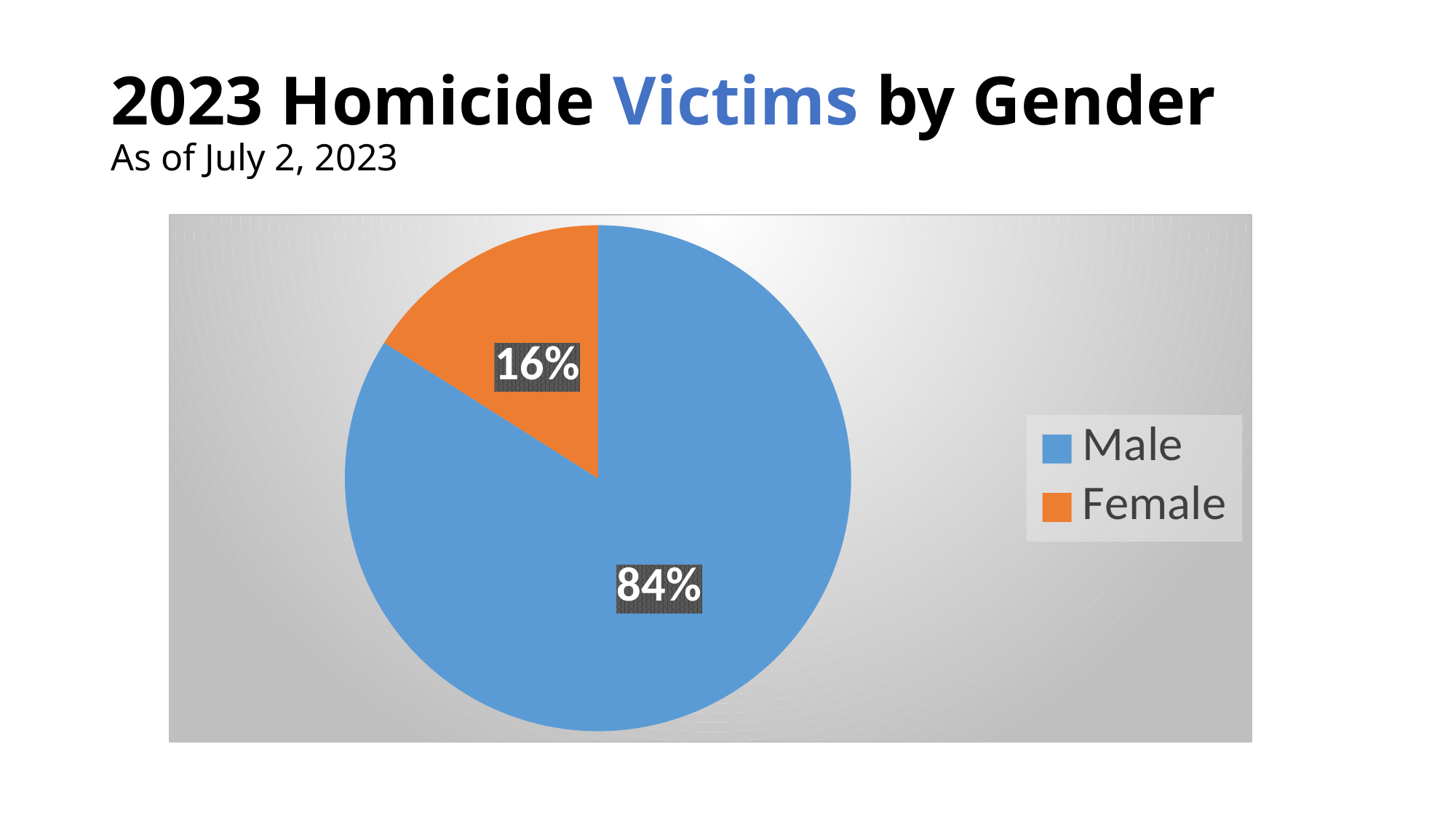
What percentage of 2023 homicide victims were female? 16% What percentage of 2023 homicide victims were male? 84% How many categories does the pie chart show? 2 What is the difference in percentage points between the male and female shares? 68 What kind of chart is shown on the slide? Pie chart What share of the pie does the Female slice represent? 16% Which gender accounts for the smallest share of homicide victims? Female What colour is the Female slice in the pie chart? Orange What is the title of the slide? 2023 Homicide Victims by Gender Which is larger, the share of male victims or the share of female victims? Male How many entries does the legend list? 2 Which gender accounts for the largest share of homicide victims? Male